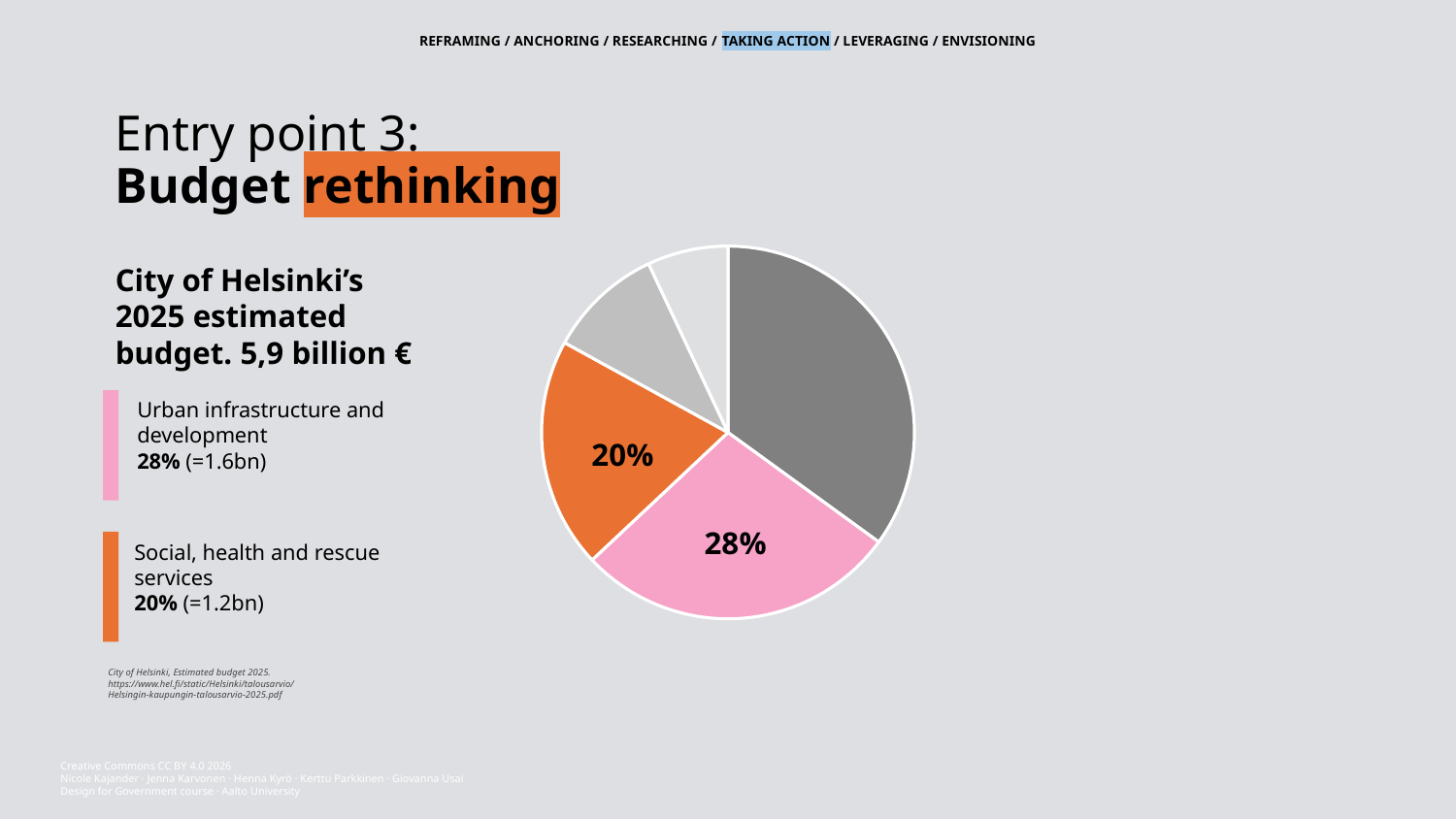
Which of the two labelled categories has the larger share: Urban infrastructure and development or Social, health and rescue services? Urban infrastructure and development What colour is the slice representing Urban infrastructure and development? pink What colour is the slice representing Social, health and rescue services? orange What is the combined share of the two labelled categories, Urban infrastructure and development and Social, health and rescue services? 48% What kind of chart is shown on the slide? pie chart What is the euro amount given for Social, health and rescue services? 1.2bn What is the euro amount given for Urban infrastructure and development? 1.6bn What is the total estimated 2025 budget stated on the slide? 5,9 billion € What share of the budget goes to Urban infrastructure and development? 28% What is the difference in percentage points between the Urban infrastructure and development share and the Social, health and rescue services share? 8 How many slices does the pie chart have? 5 What share of the budget goes to Social, health and rescue services? 20%